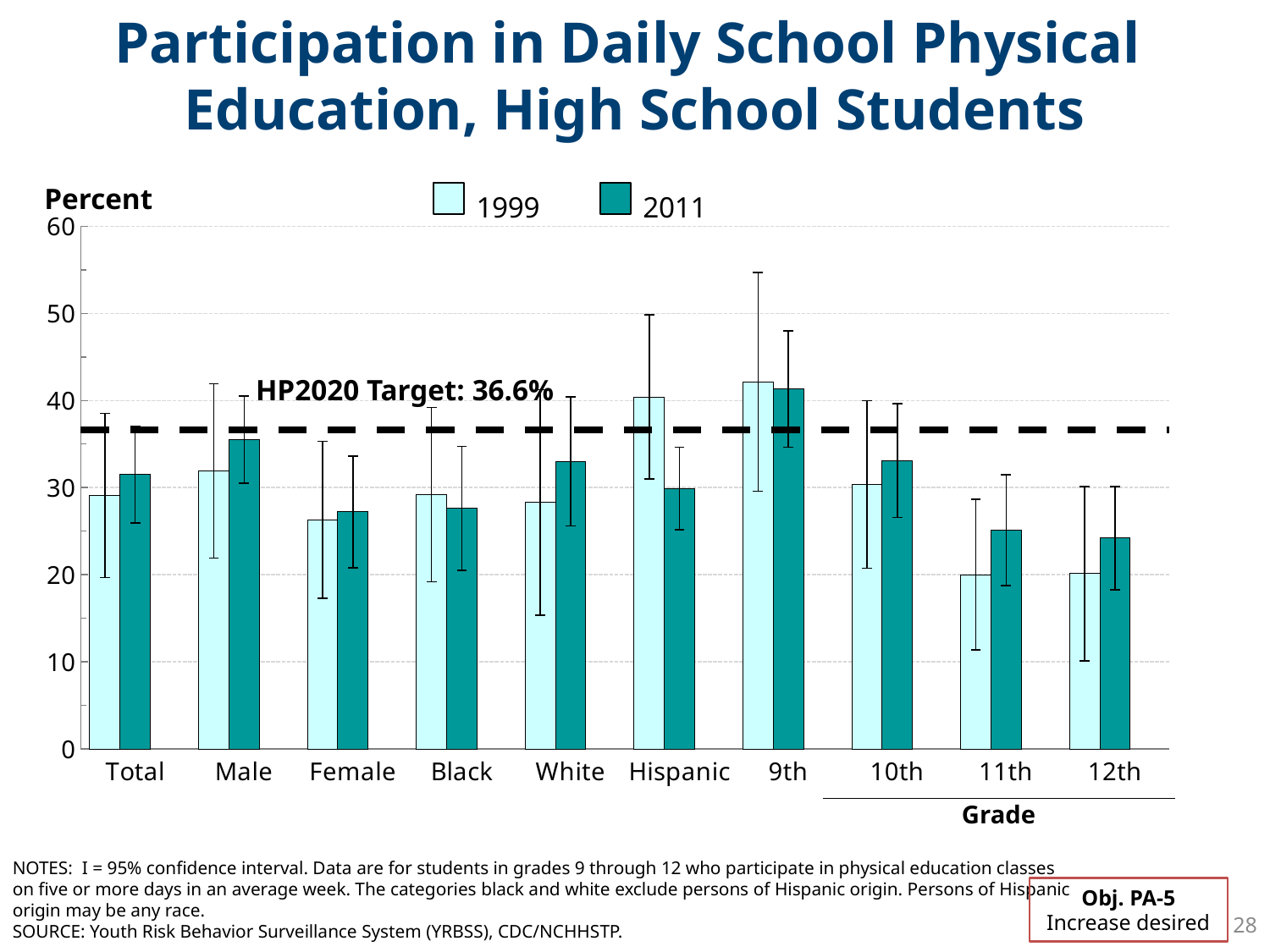
How many series does the legend list? 2 For White, which year has the larger value, 1999 or 2011? 2011 Is the 1999 value for 11th grade greater or less than 30? less Is the 2011 value for Male greater or less than 30? greater Which category has the highest value for 2011? 9th What kind of chart is shown on the slide? bar chart Is the 1999 value for 9th grade greater or less than 40? greater For Hispanic, which year has the larger value, 1999 or 2011? 1999 What is the HP2020 Target value shown on the chart? 36.6% Which years are listed in the legend? 1999 and 2011 How many categories are shown along the x axis? 10